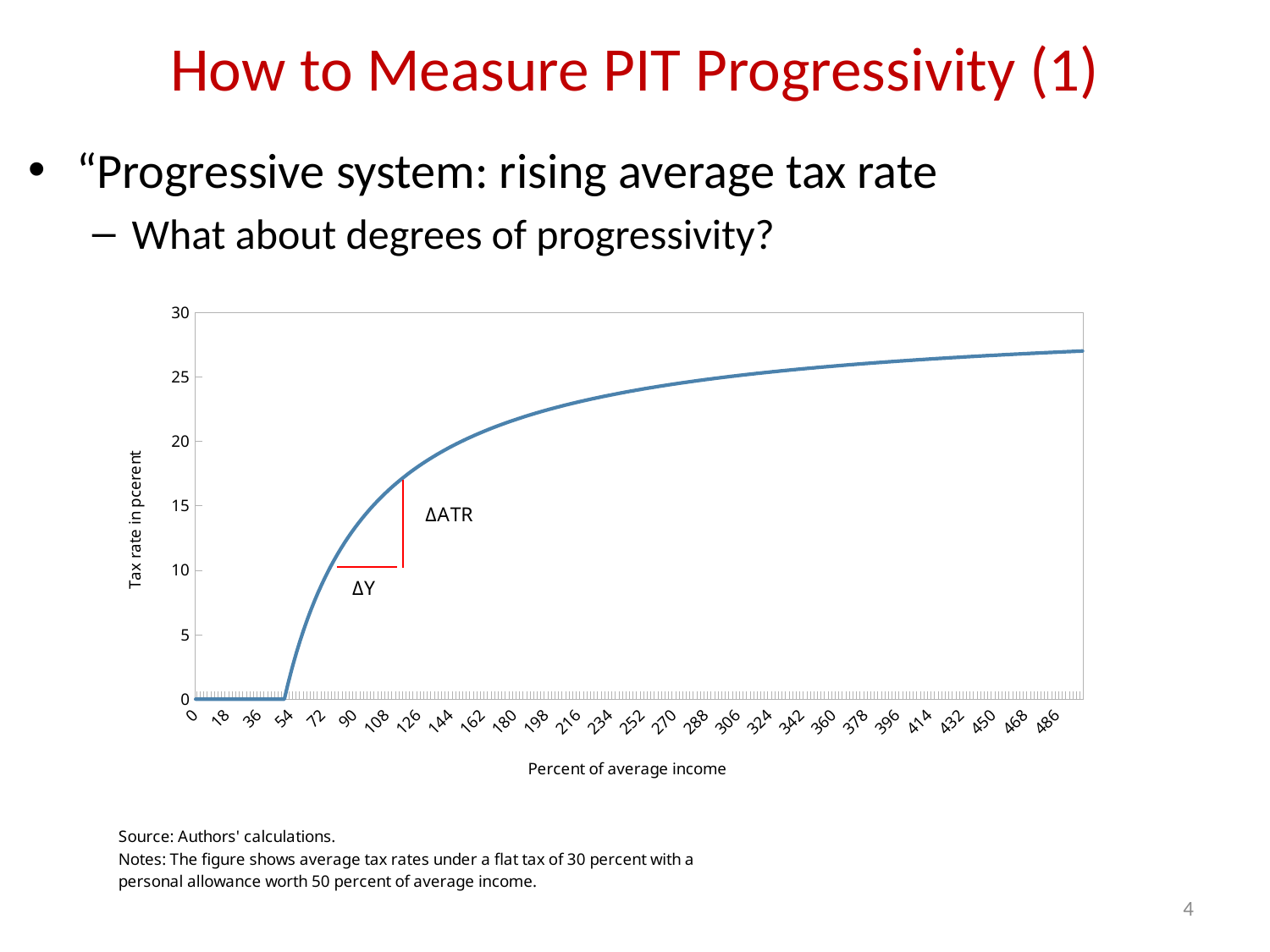
Does the tax rate rise or fall as percent of average income increases beyond 54? rise Is the tax rate at 198 percent of average income greater or less than 20? greater Is the tax rate at 486 percent of average income greater or less than 30? less What is the tax rate at 18 percent of average income? 0 What is the title of the y axis? Tax rate in pcerent Which is larger, the tax rate at 72 percent of average income or at 270 percent of average income? 270 What kind of chart is shown on the slide? line chart Is the tax rate at 486 percent of average income greater or less than 25? greater What is the title of the x axis? Percent of average income What is the tax rate at 36 percent of average income? 0